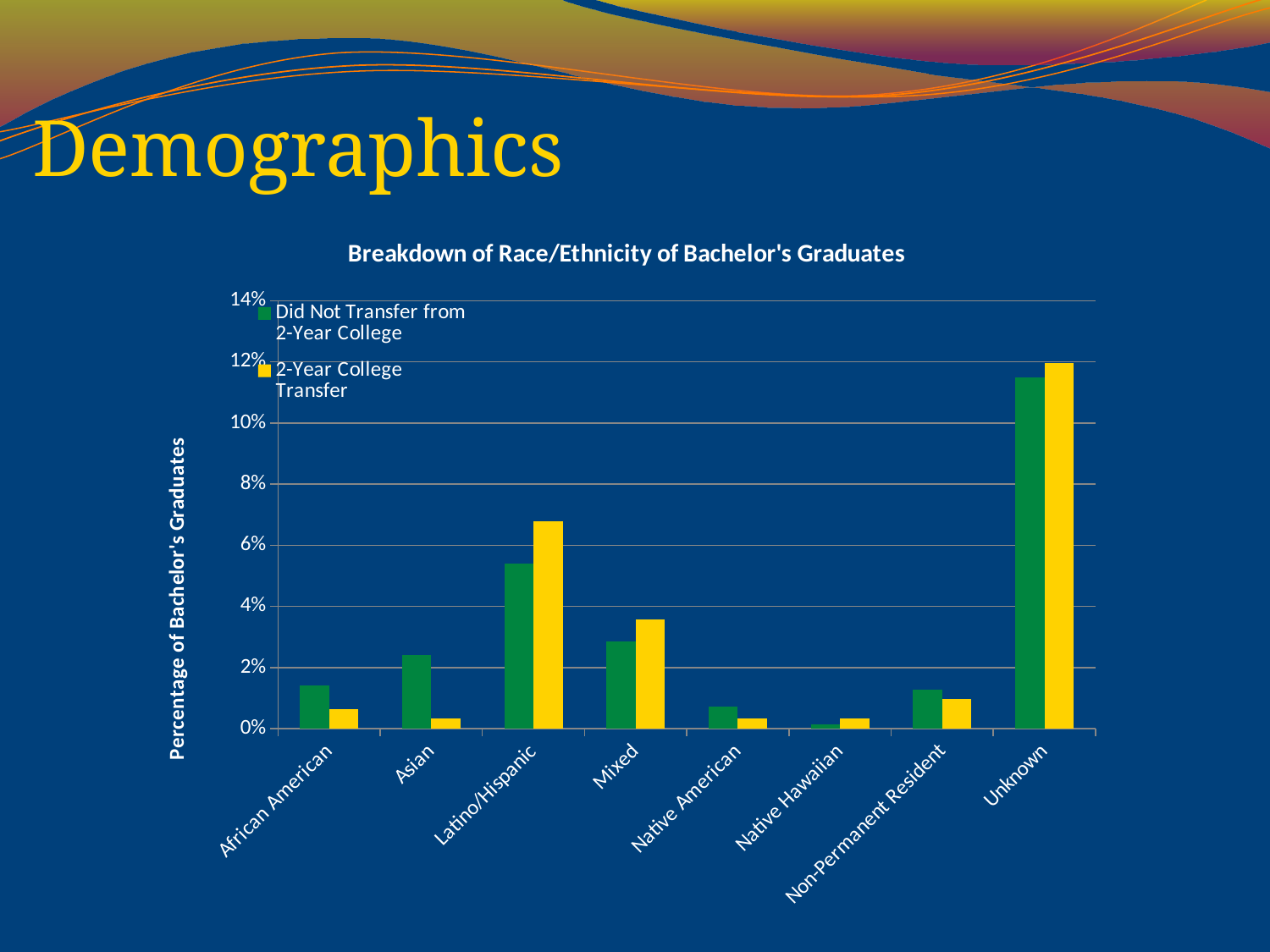
For Latino/Hispanic, which series has the larger value: Did Not Transfer from 2-Year College or 2-Year College Transfer? 2-Year College Transfer Is the Did Not Transfer from 2-Year College value for Asian greater or less than 2%? greater How many series does the legend list? 2 What is the title of the chart? Breakdown of Race/Ethnicity of Bachelor's Graduates Is the 2-Year College Transfer value for Mixed greater or less than 4%? less Which category has the lowest value for the Did Not Transfer from 2-Year College series? Native Hawaiian For Asian, which series has the larger value: Did Not Transfer from 2-Year College or 2-Year College Transfer? Did Not Transfer from 2-Year College How many race/ethnicity categories are shown on the x axis? 8 What kind of chart is shown on the slide? bar chart Is the 2-Year College Transfer value for Latino/Hispanic greater or less than 6%? greater Which category has the highest value for the 2-Year College Transfer series? Unknown